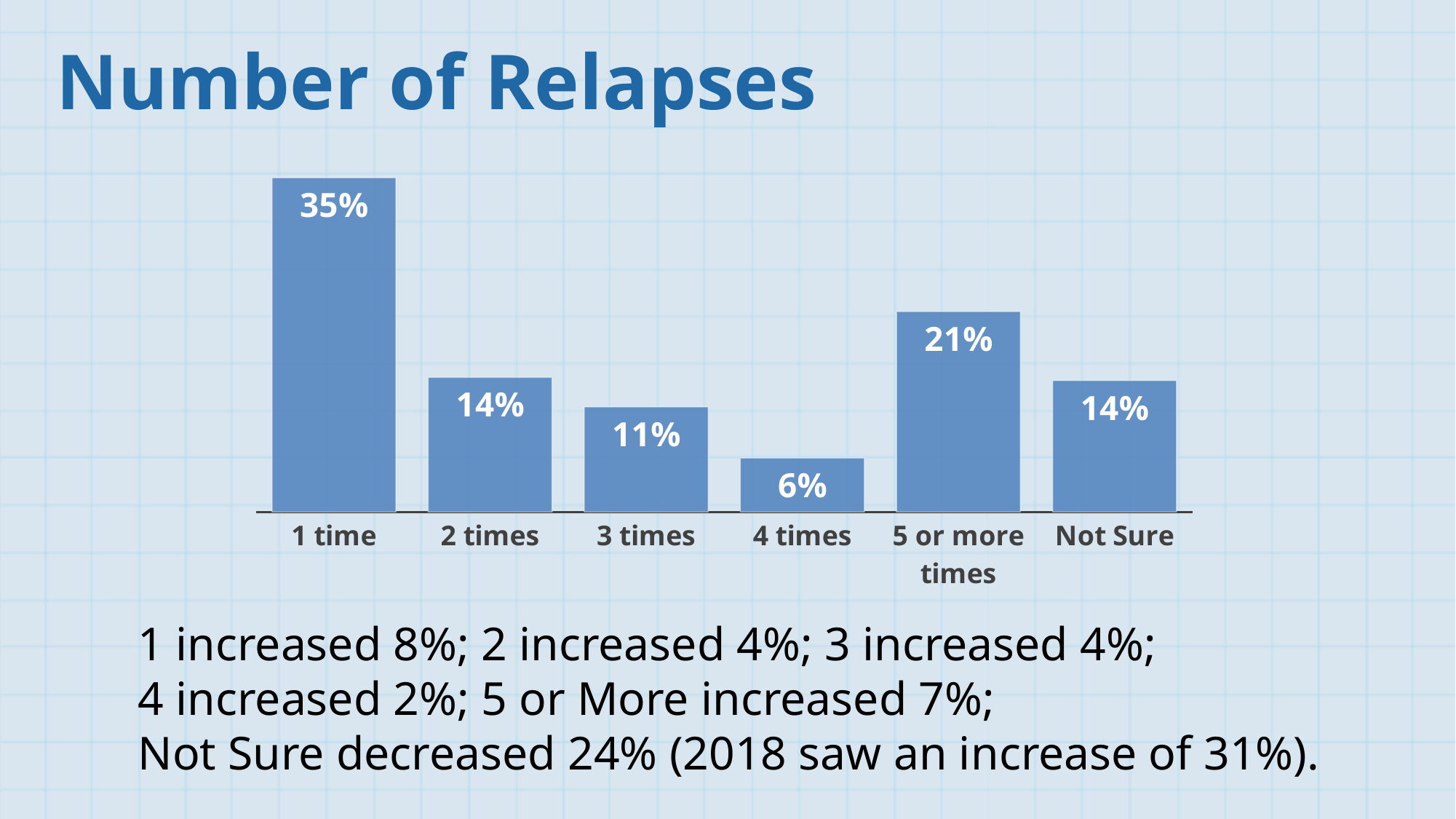
What percentage is shown for 1 time? 35% Which category has the lowest value? 4 times What kind of chart is shown on the slide? Bar chart What percentage is shown for Not Sure? 14% What is the title of the slide? Number of Relapses What percentage is shown for 4 times? 6% How many categories are shown on the x axis? 6 Which is larger, the value for 3 times or the value for 5 or more times? 5 or more times What is the difference between the values for 2 times and 3 times? 3% Which category has the highest value? 1 time What percentage is shown for 5 or more times? 21% What is the difference between the values for 1 time and 5 or more times? 14%